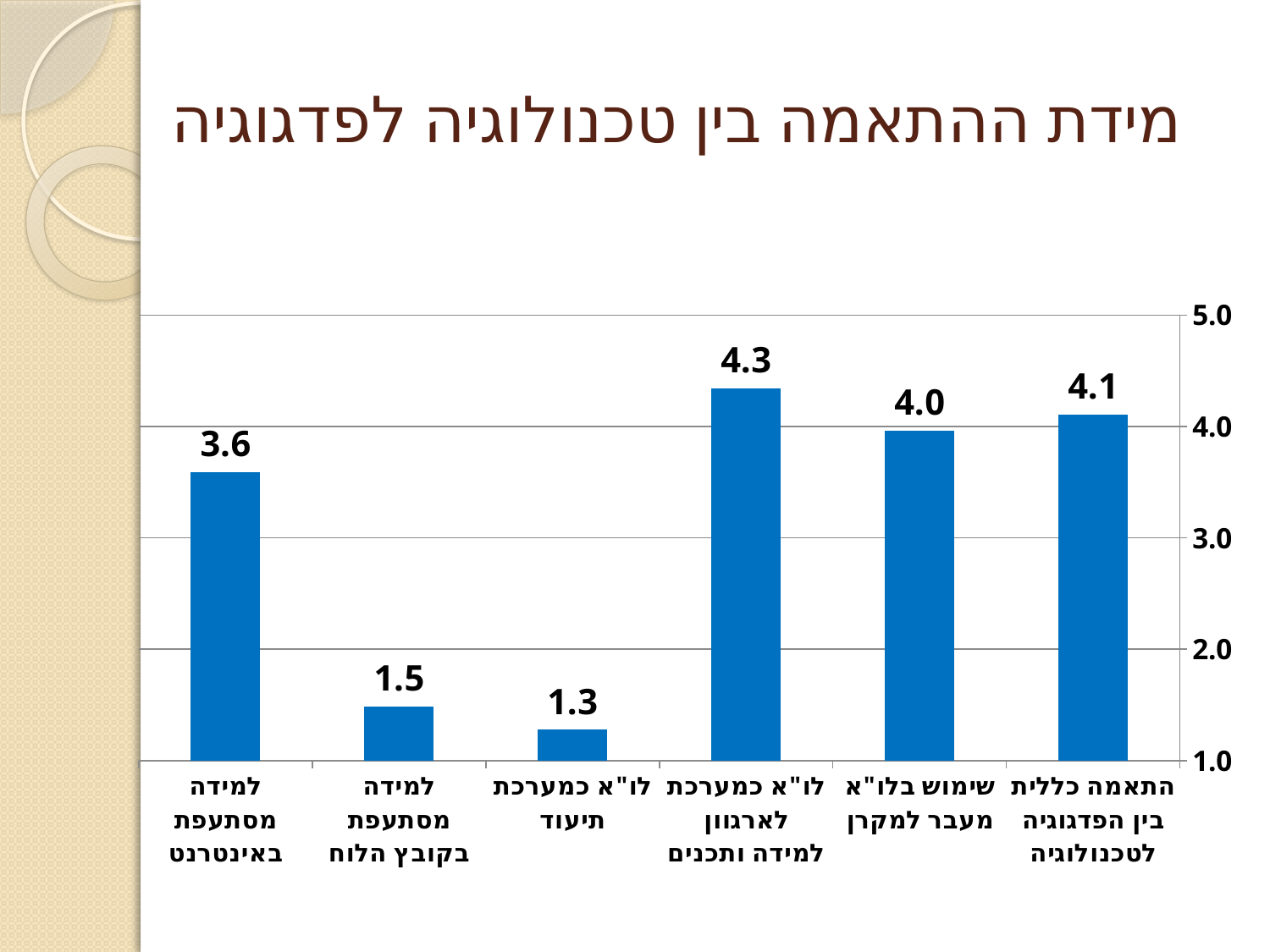
Which is larger: the value for "למידה מסתעפת באינטרנט" or the value for "למידה מסתעפת בקובץ הלוח"? למידה מסתעפת באינטרנט What is the title of the slide? מידת ההתאמה בין טכנולוגיה לפדגוגיה Which category has the highest value? לו"א כמערכת לארגוון למידה ותכנים What is the value for "שימוש בלו"א מעבר למקרן"? 4.0 What is the value for "התאמה כללית בין הפדגוגיה לטכנולוגיה"? 4.1 What is the value for "לו"א כמערכת תיעוד"? 1.3 What is the value for "למידה מסתעפת באינטרנט"? 3.6 What kind of chart is shown on the slide? bar chart How many categories are shown in the chart? 6 Is the value for "למידה מסתעפת בקובץ הלוח" greater or less than 2.0? less What is the difference between the values for "לו"א כמערכת לארגוון למידה ותכנים" and "למידה מסתעפת בקובץ הלוח"? 2.8 Which category has the lowest value? לו"א כמערכת תיעוד